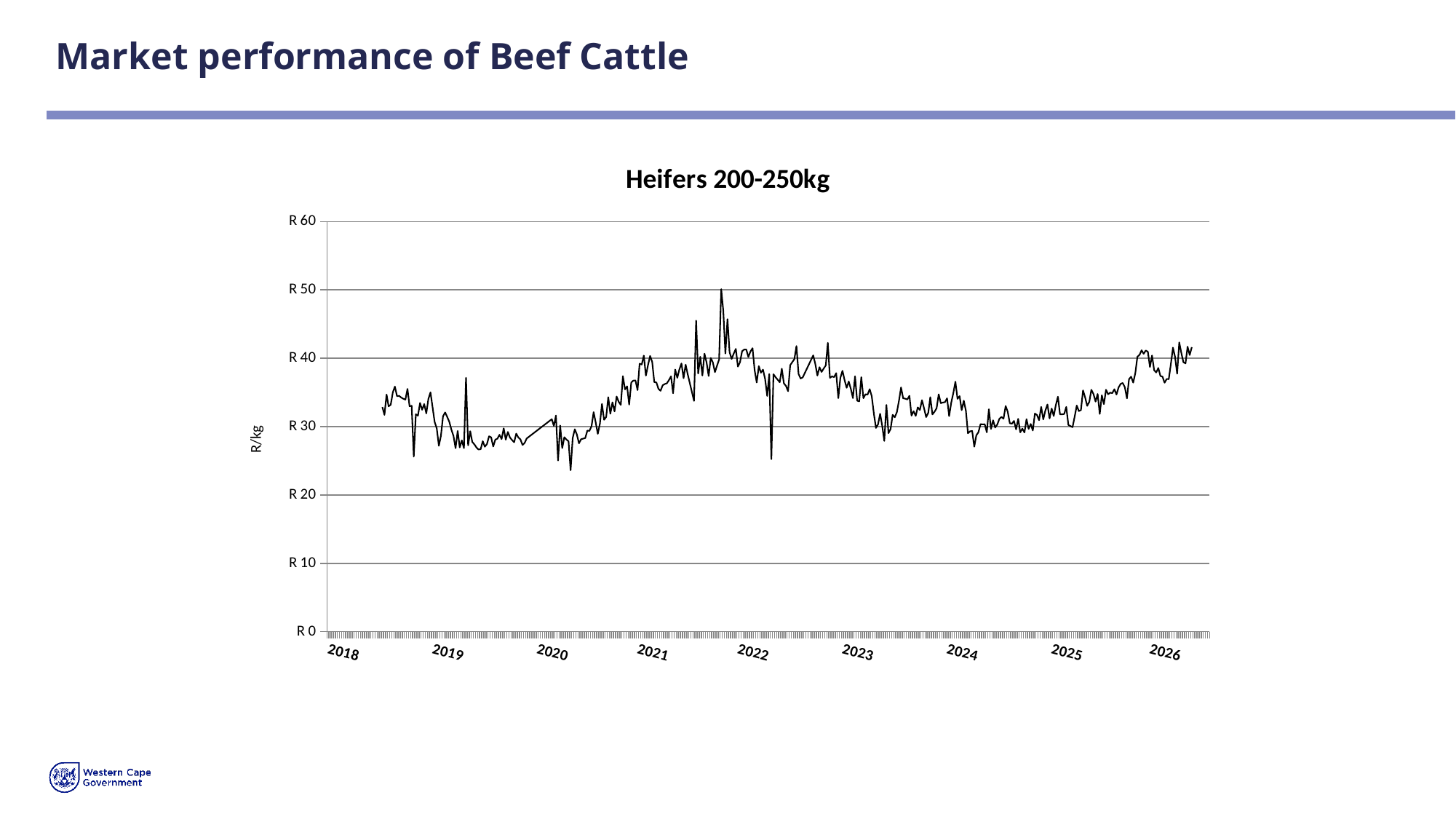
Does the line generally rise or fall between 2022 and 2024? fall Is the value at the very end of the series, in 2026, greater or less than R 30? greater What is the highest value shown on the vertical axis? R 60 Is the lowest point of the line, reached in early 2020, greater or less than R 30? less What is the title of the chart? Heifers 200-250kg How many lines are plotted on the chart? 1 What is the label on the vertical axis of the chart? R/kg What kind of chart is shown on the slide? line chart How many year labels are shown on the horizontal axis? 9 Is the highest peak of the line, reached in late 2021, greater or less than R 40? greater Does the line generally rise or fall between 2024 and 2026? rise